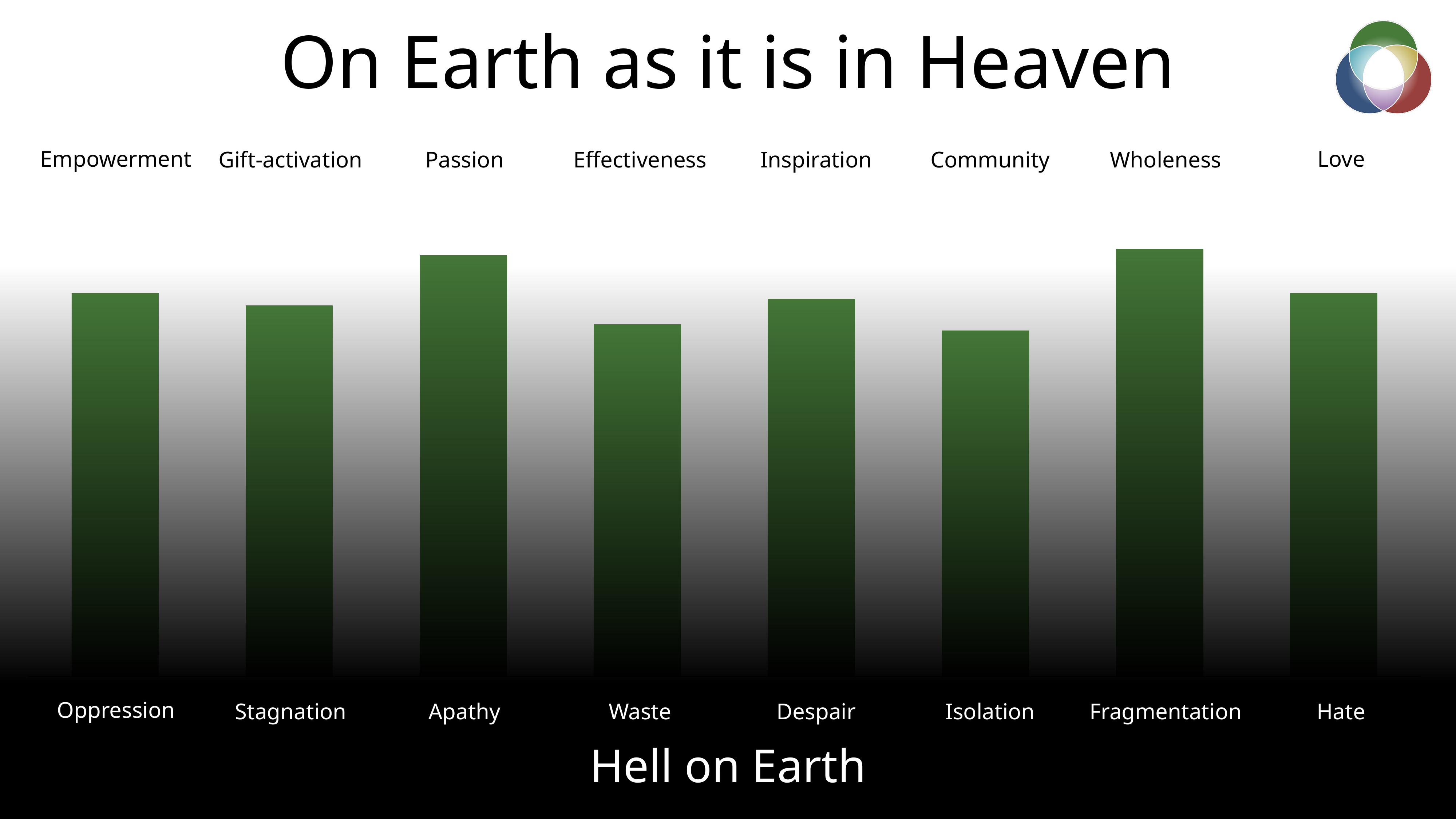
Which bar is taller, Oppression or Waste? Oppression What kind of chart is shown on the slide? bar chart Which bar is taller, Despair or Isolation? Despair Which bar is taller, Stagnation or Waste? Stagnation Which category has the shortest bar? Isolation How many bars does the chart contain? 8 What label appears above the bar labelled Apathy at the top of the chart? Passion What label appears below the x-axis categories at the bottom of the chart? Hell on Earth Which category has the tallest bar? Fragmentation What is the title of the chart? On Earth as it is in Heaven